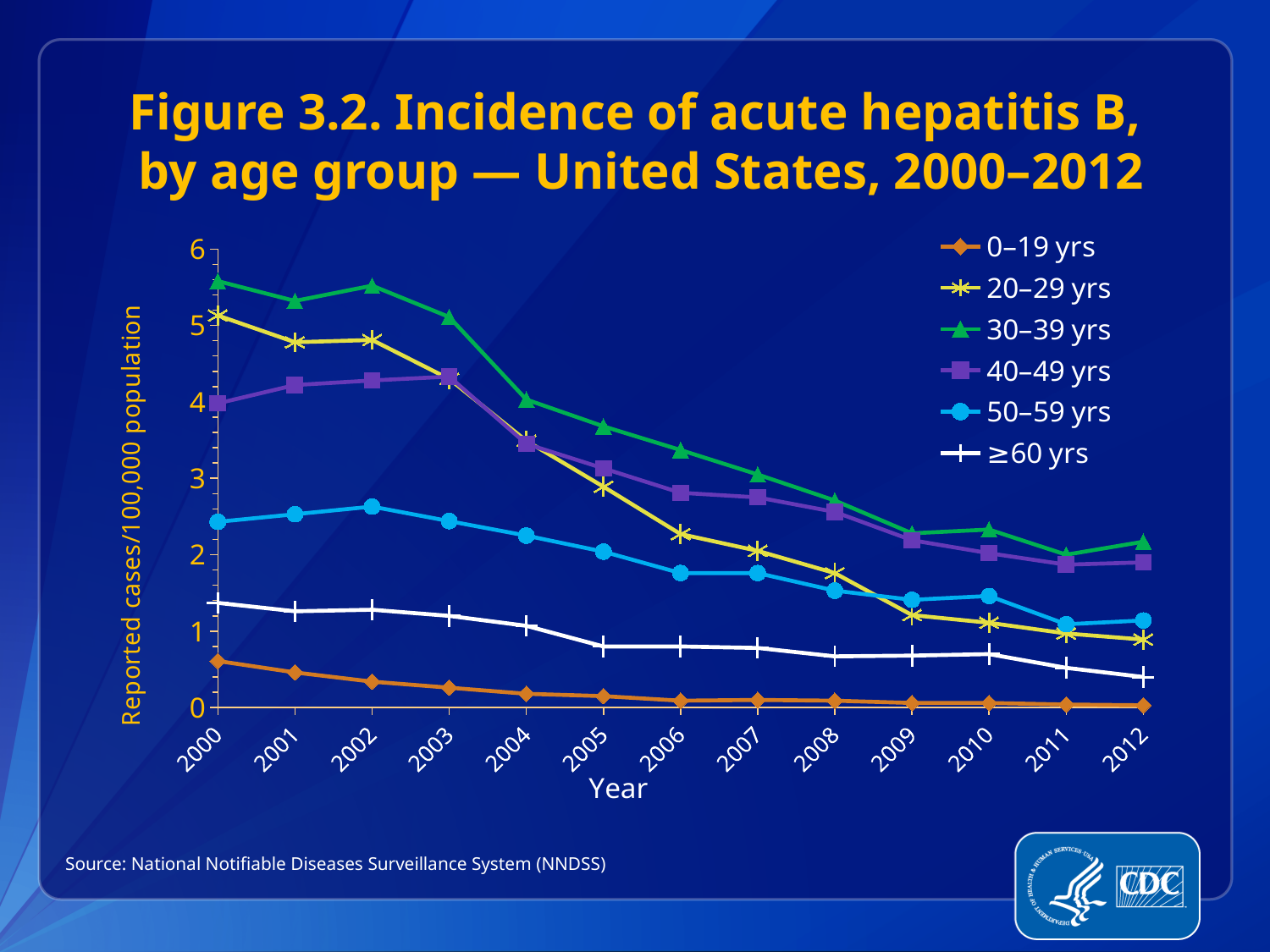
How many years are plotted along the x axis? 13 Is the value for the 50–59 yrs group in 2000 greater or less than 2? greater What is the label of the y axis? Reported cases/100,000 population Does the incidence for the 30–39 yrs group rise or fall from 2000 to 2012? Fall Is the value for the 30–39 yrs group in 2000 greater or less than 5? greater What kind of chart is shown on the slide? Line chart In 2005, which is larger: the value for the 30–39 yrs group or the 50–59 yrs group? 30–39 yrs What is the title of the chart? Figure 3.2. Incidence of acute hepatitis B, by age group — United States, 2000–2012 Which age group has the highest incidence in 2000? 30–39 yrs Is the value for the 0–19 yrs group in 2012 greater or less than 1? less How many series does the legend list? 6 Which age group has the lowest incidence in 2012? 0–19 yrs